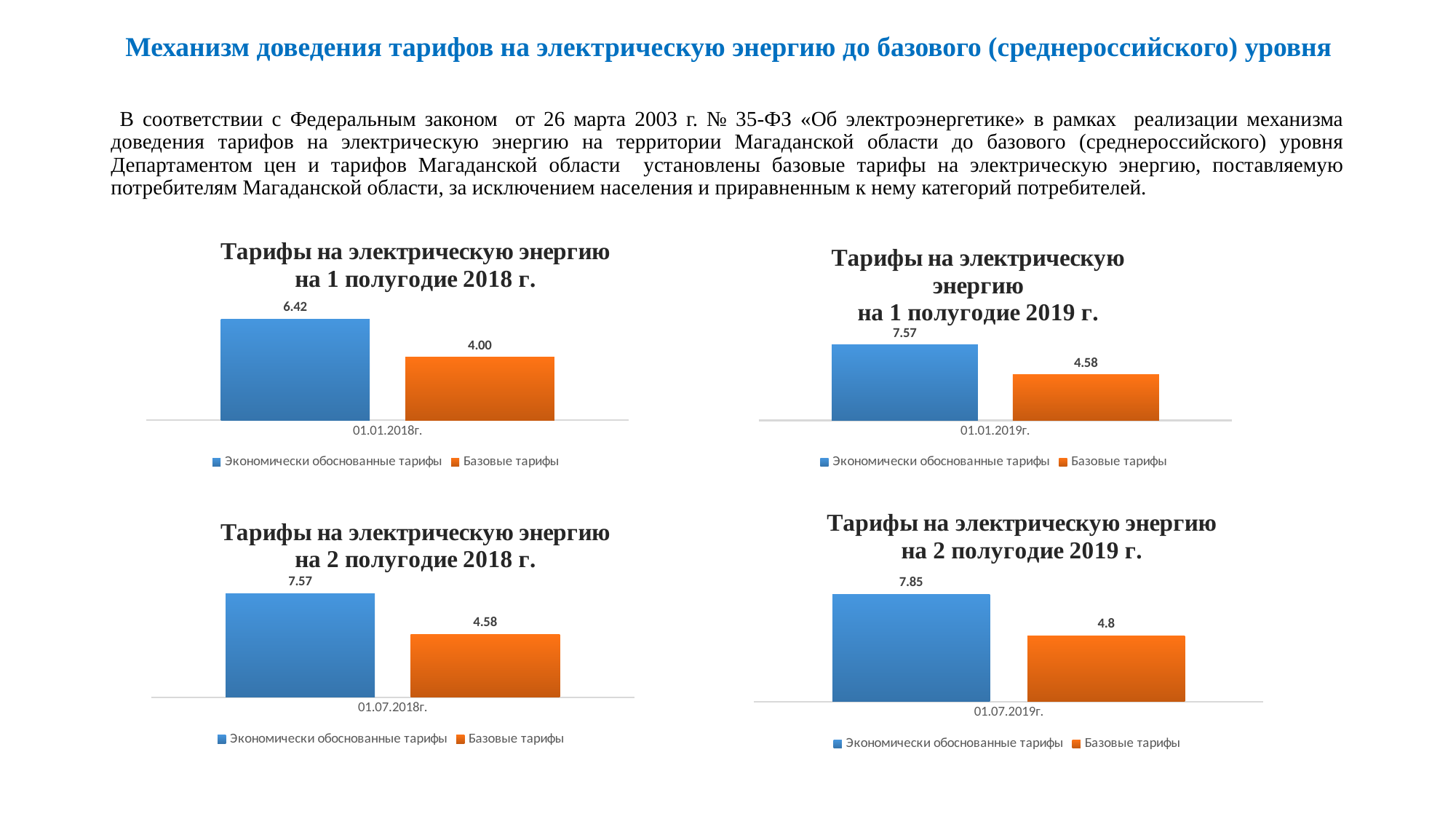
In the chart 'Тарифы на электрическую энергию на 1 полугодие 2018 г.' (top-left), what is the value for Экономически обоснованные тарифы? 6.42 In the chart 'Тарифы на электрическую энергию на 1 полугодие 2019 г.' (top-right), what colour is the bar for Базовые тарифы? Orange In the chart 'Тарифы на электрическую энергию на 2 полугодие 2019 г.' (bottom-right), which series has the lowest value? Базовые тарифы What kind of chart is 'Тарифы на электрическую энергию на 2 полугодие 2018 г.' (bottom-left)? Bar chart In the chart 'Тарифы на электрическую энергию на 2 полугодие 2019 г.' (bottom-right), what is the difference between Экономически обоснованные тарифы and Базовые тарифы? 3.05 In the chart 'Тарифы на электрическую энергию на 2 полугодие 2018 г.' (bottom-left), what is the difference between Экономически обоснованные тарифы and Базовые тарифы? 2.99 What is the x-axis category label in the chart 'Тарифы на электрическую энергию на 2 полугодие 2018 г.' (bottom-left)? 01.07.2018г. In the chart 'Тарифы на электрическую энергию на 2 полугодие 2019 г.' (bottom-right), what is the value for Базовые тарифы? 4.8 In the chart 'Тарифы на электрическую энергию на 1 полугодие 2018 г.' (top-left), which series has the higher value? Экономически обоснованные тарифы How many series does the legend list in the chart 'Тарифы на электрическую энергию на 1 полугодие 2019 г.' (top-right)? 2 In the chart 'Тарифы на электрическую энергию на 1 полугодие 2019 г.' (top-right), what is the value for Экономически обоснованные тарифы? 7.57 In the chart 'Тарифы на электрическую энергию на 1 полугодие 2018 г.' (top-left), what is the value for Базовые тарифы? 4.00